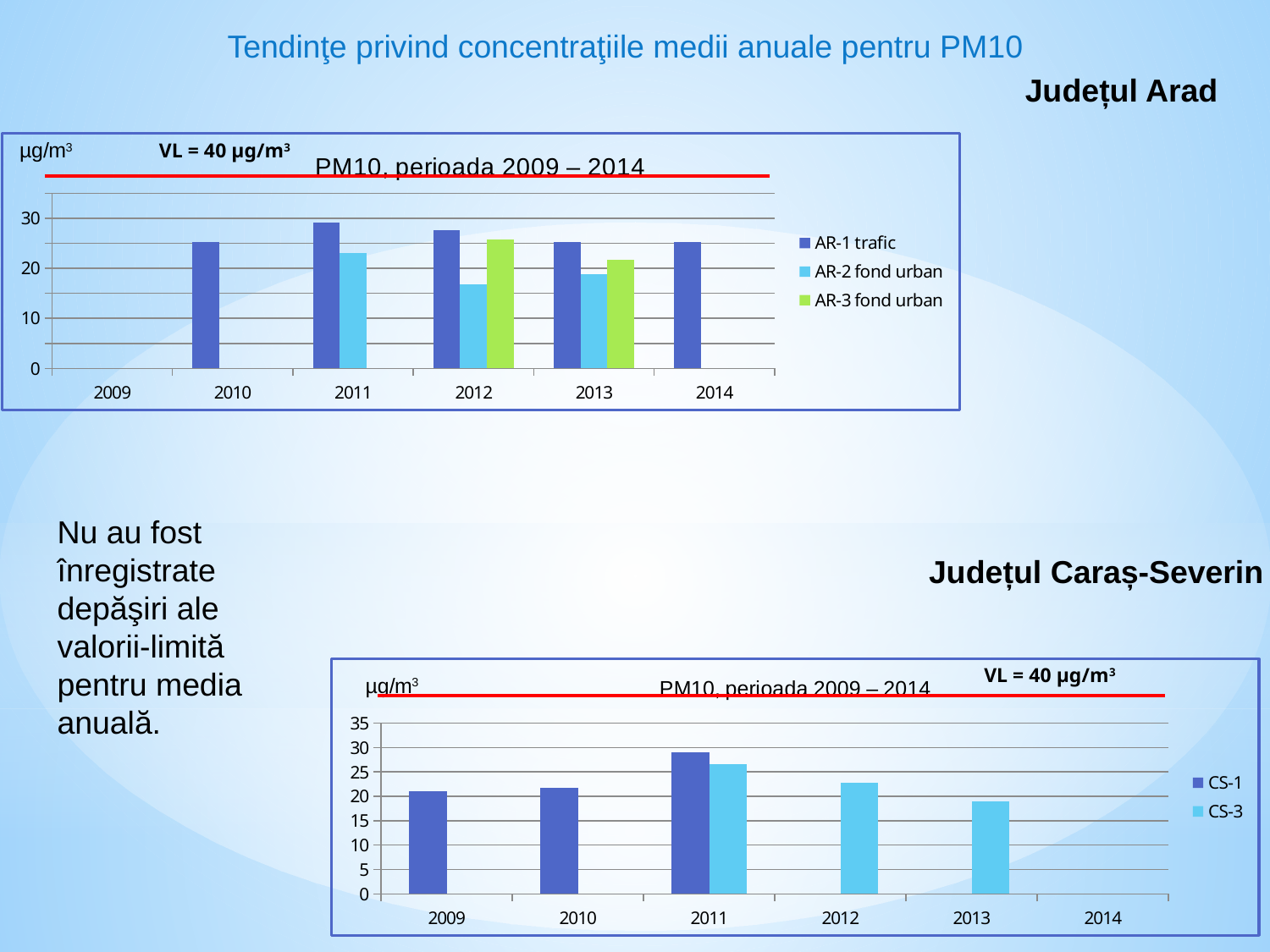
In the Județul Caraș-Severin chart, in which year is the CS-1 value highest? 2011 In the Județul Caraș-Severin chart, is the CS-3 value for 2012 greater or less than 20? greater How many series does the legend of the Județul Caraș-Severin chart at the bottom of the slide list? 2 What kind of chart is the Județul Arad chart (PM10, perioada 2009 – 2014) at the top of the slide? bar chart What are the legend entries of the Județul Arad chart? AR-1 trafic, AR-2 fond urban, AR-3 fond urban In the Județul Arad chart, which is larger in 2012: AR-2 fond urban or AR-3 fond urban? AR-3 fond urban How many series does the legend of the Județul Arad chart list? 3 In the Județul Arad chart, is the AR-2 fond urban value for 2012 greater or less than 20? less In the Județul Arad chart, in which year is the AR-1 trafic value highest? 2011 In the Județul Caraș-Severin chart, which is larger in 2011: CS-1 or CS-3? CS-1 In the Județul Arad chart, is the AR-3 fond urban value for 2012 greater or less than 20? greater How many years are shown on the x axis of the Județul Arad chart? 6